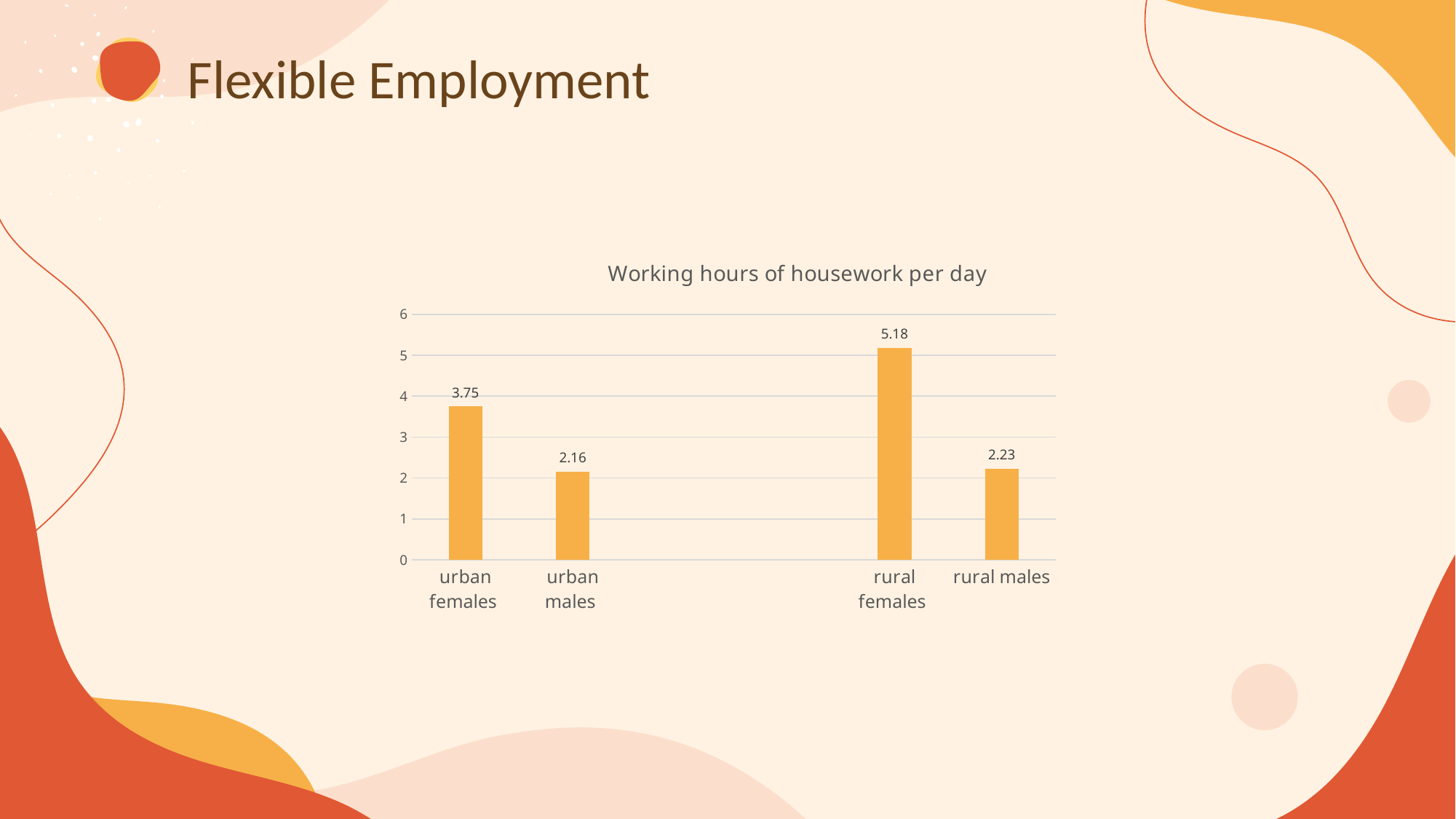
Which is larger, the value for urban females or the value for rural males? urban females Which category has the highest value? rural females What is the title of the chart? Working hours of housework per day What kind of chart is shown on the slide? bar chart What is the difference between the values for rural females and urban females? 1.43 What is the value for rural males? 2.23 Is the value for rural females greater or less than 5? greater What is the value for urban males? 2.16 What is the difference between the values for rural males and urban males? 0.07 What is the value for urban females? 3.75 Which category has the lowest value? urban males How many categories are shown in the chart? 4